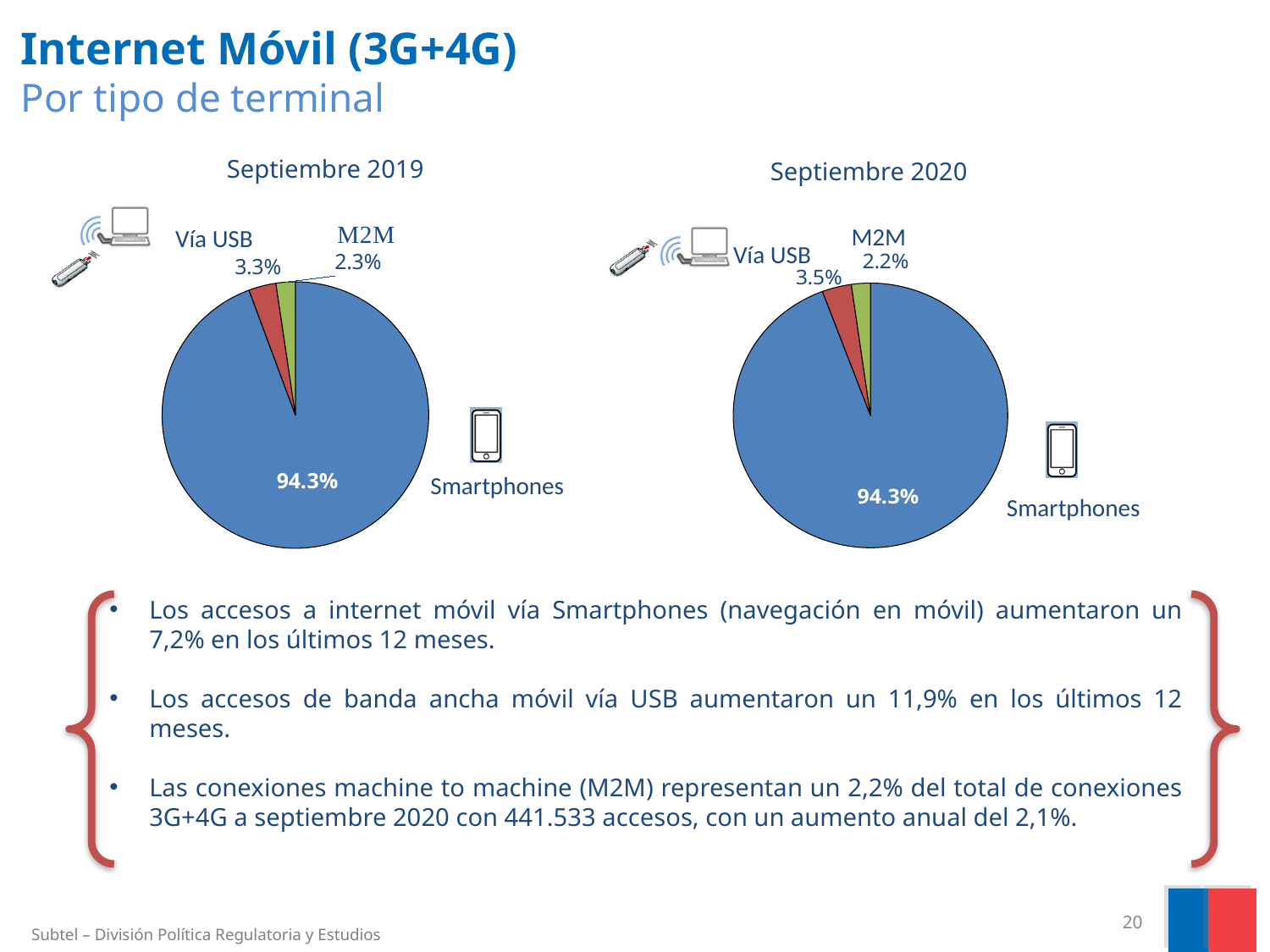
What colour is the Smartphones slice in the Septiembre 2019 pie chart? Blue In the Septiembre 2020 pie chart, which is larger, Vía USB or M2M? Vía USB In the Septiembre 2020 pie chart, which category has the largest slice? Smartphones What is the difference between the Vía USB share in Septiembre 2020 and in Septiembre 2019? 0.2% In the Septiembre 2020 pie chart, what share does M2M have? 2.2% In the Septiembre 2020 pie chart, what share does Vía USB have? 3.5% What type of chart is used for Septiembre 2020? Pie chart In the Septiembre 2019 pie chart, what share do Smartphones have? 94.3% In the Septiembre 2019 pie chart, which category has the smallest slice? M2M In the Septiembre 2019 pie chart, what share does M2M have? 2.3% In the Septiembre 2019 pie chart, what share does Vía USB have? 3.3% How many categories does the Septiembre 2019 pie chart show? 3